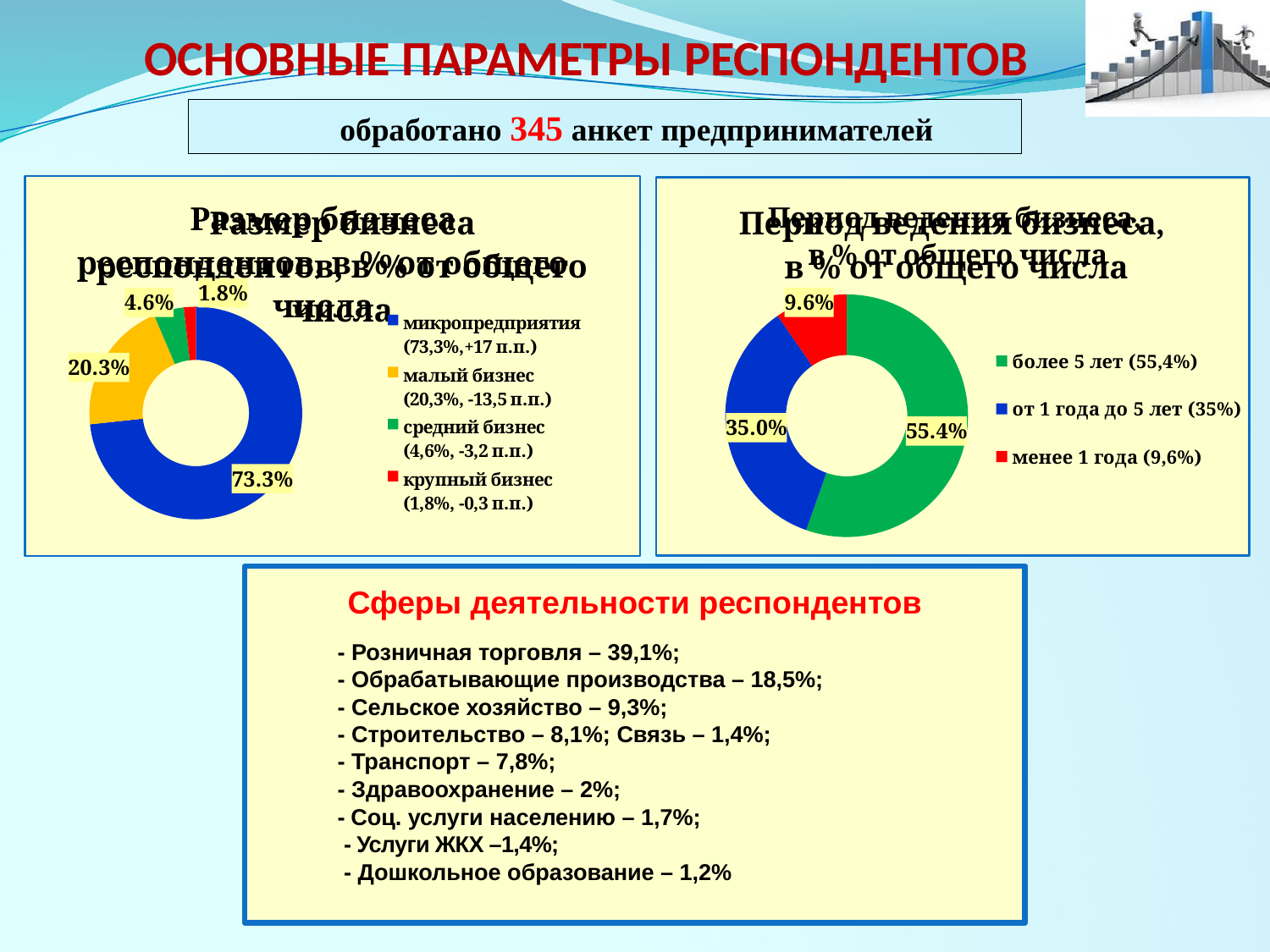
On the right chart (Период ведения бизнеса), which category has the largest share? более 5 лет On the left chart (Размер бизнеса респондентов), which category has the smallest share? крупный бизнес On the right chart (Период ведения бизнеса), what is the value for менее 1 года? 9.6% On the right chart (Период ведения бизнеса), what is the difference between более 5 лет and от 1 года до 5 лет? 20.4% On the left chart (Размер бизнеса респондентов), what is the value for микропредприятия? 73.3% On the left chart (Размер бизнеса респондентов), what is the difference between the shares of малый бизнес and средний бизнес? 15.7% On the right chart (Период ведения бизнеса), how many entries does the legend list? 3 On the left chart (Размер бизнеса респондентов), how many categories are shown? 4 On the left chart (Размер бизнеса респондентов), what is the value for малый бизнес? 20.3% What kind of chart is the left chart (Размер бизнеса респондентов)? Doughnut chart On the right chart (Период ведения бизнеса), which is larger: от 1 года до 5 лет or менее 1 года? от 1 года до 5 лет On the right chart (Период ведения бизнеса), what colour is the slice for более 5 лет? Green